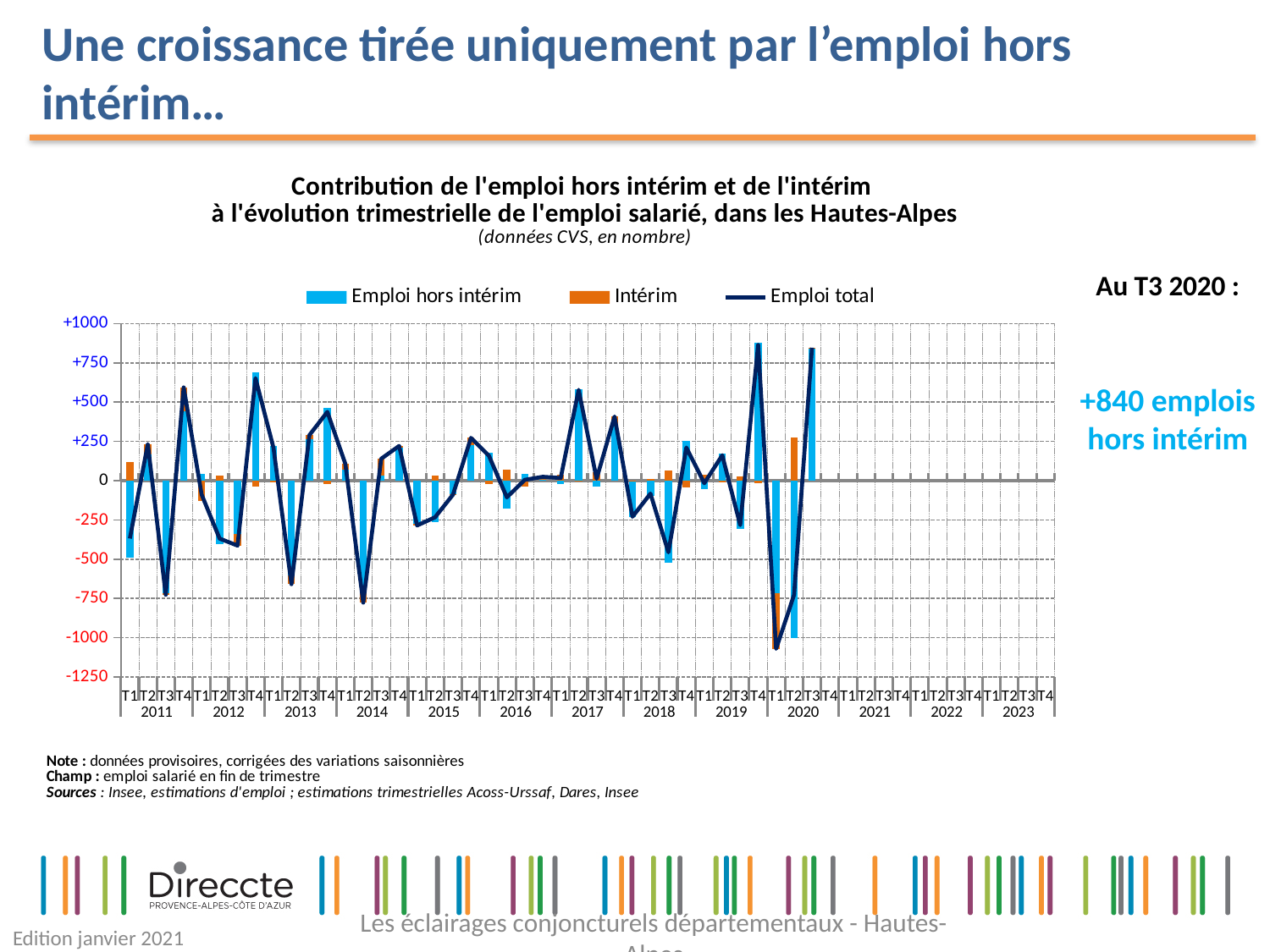
How many series does the chart legend list? 3 In which quarter is the Intérim bar the lowest? T1 2020 Which colour represents the Intérim series in the chart? Orange In which quarter is the Emploi hors intérim bar the lowest? T2 2020 In which quarter does the Emploi total line reach its lowest point? T1 2020 Which is larger, the Emploi hors intérim bar at T4 2012 or at T4 2013? T4 2012 Is the value of Emploi total at T4 2019 greater or less than +750? greater In which quarter is the Emploi hors intérim bar the highest? T4 2019 Is the value of Emploi hors intérim at T1 2020 greater or less than -750? greater What kind of chart is this? Combined bar and line chart According to the annotation on the slide, what is the value of Emploi hors intérim at T3 2020? +840 How many year labels appear along the x axis? 13